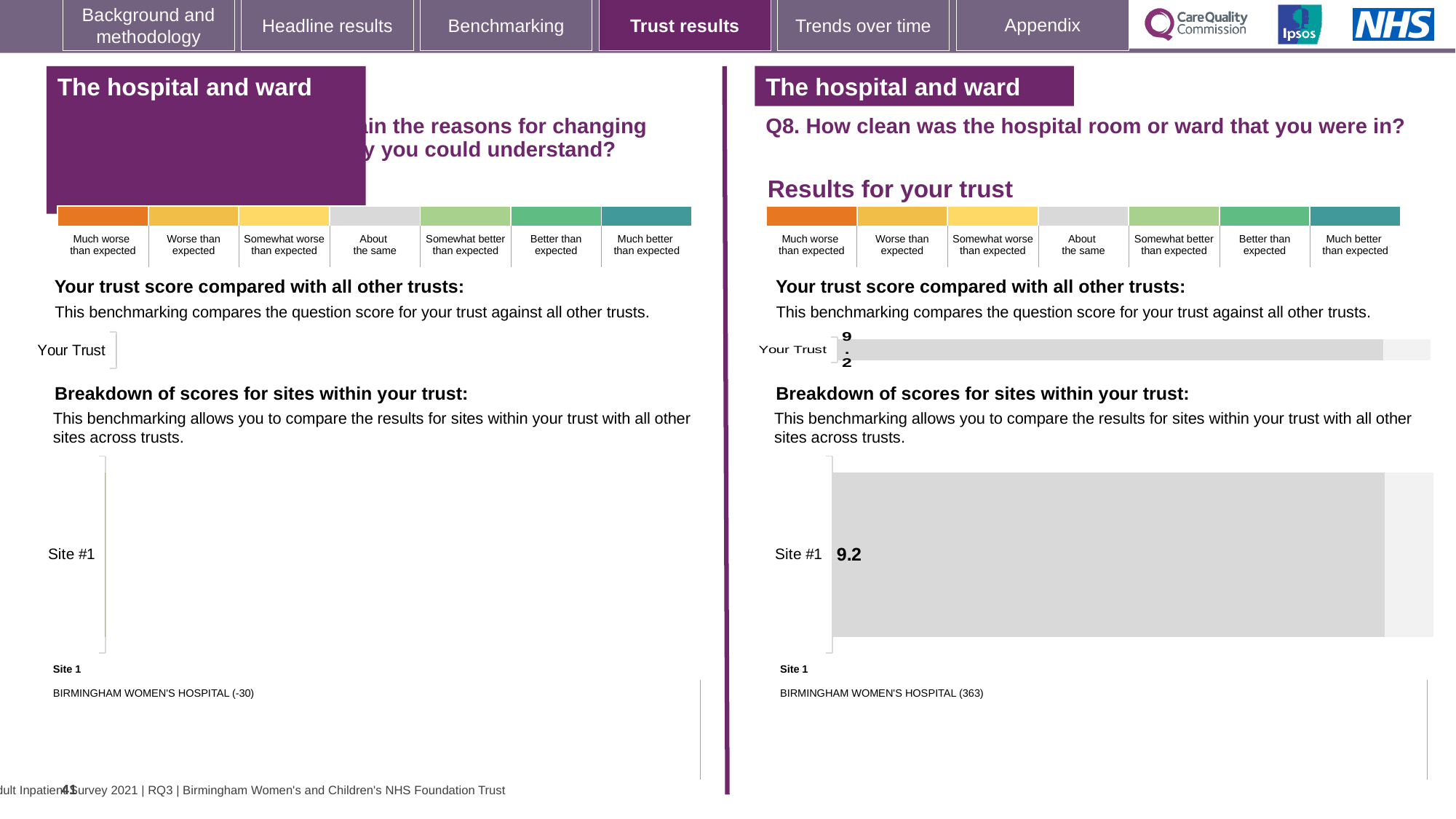
On the right-hand Q8 charts, what is the difference between the Your Trust score and the Site #1 score? 0 On the right-hand 'Breakdown of scores for sites within your trust' chart for Q8, what is the value shown for Site #1? 9.2 What kind of chart is the right-hand 'Breakdown of scores for sites within your trust' chart for Q8? bar chart According to the note under the right-hand Q8 site breakdown chart, which hospital is Site 1? BIRMINGHAM WOMEN'S HOSPITAL (363) On the right-hand Q8 charts, is the Your Trust score larger than, smaller than, or equal to the Site #1 score? equal Are the bars on the right-hand Q8 'Your trust score compared with all other trusts' chart horizontal or vertical? horizontal On the right-hand 'Your trust score compared with all other trusts' chart for Q8, what is the value shown for Your Trust? 9.2 How many sites are plotted on the right-hand 'Breakdown of scores for sites within your trust' chart for Q8? 1 How many rating categories does the colour scale above the right-hand Q8 charts show, from 'Much worse than expected' to 'Much better than expected'? 7